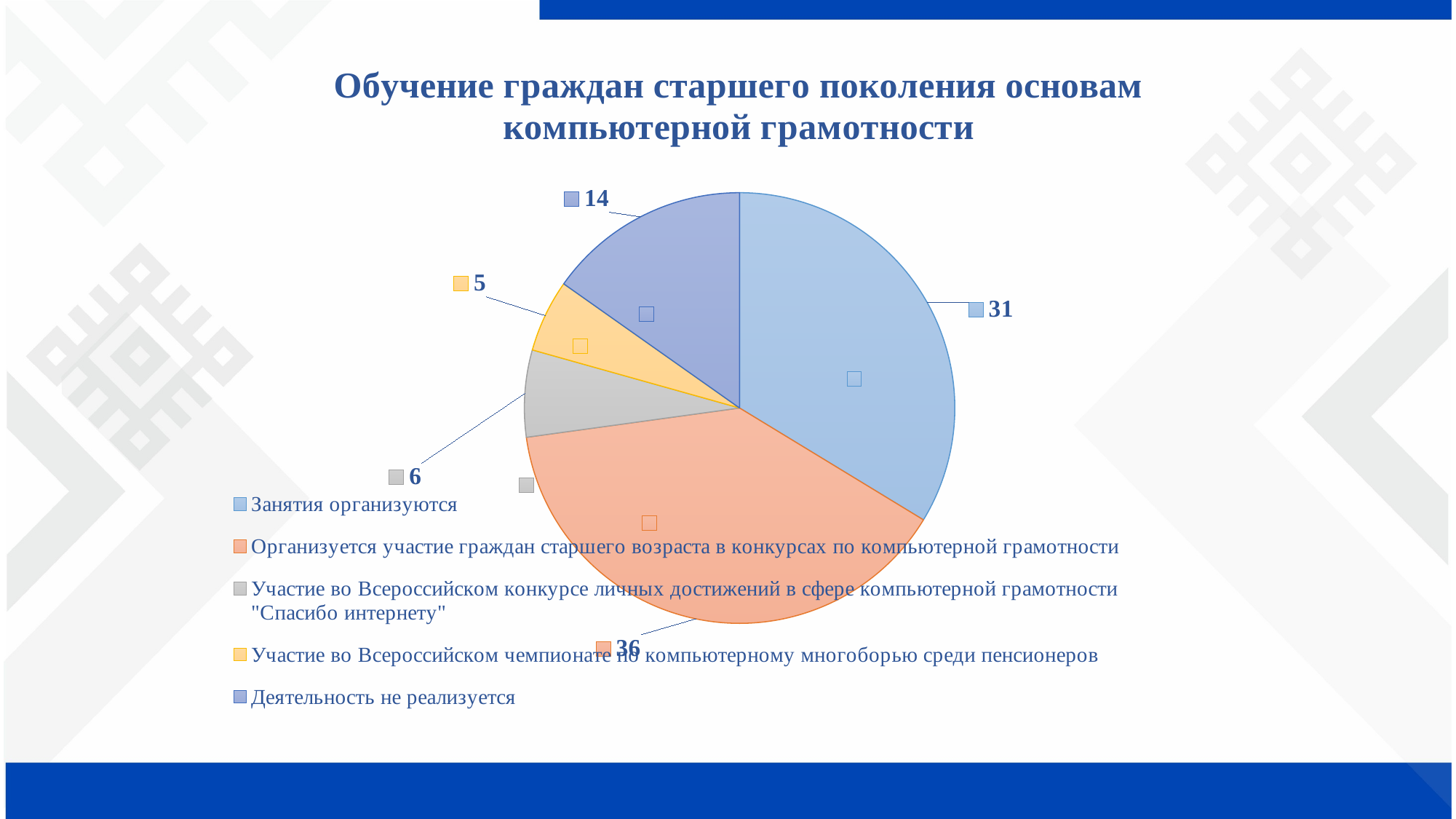
What is the value for "Деятельность не реализуется"? 14 What is the value for "Участие во Всероссийском чемпионате по компьютерному многоборью среди пенсионеров"? 5 Which is larger: the value for "Деятельность не реализуется" or the value for "Занятия организуются"? Занятия организуются How many categories does the pie chart have? 5 What is the value for "Участие во Всероссийском конкурсе личных достижений в сфере компьютерной грамотности "Спасибо интернету""? 6 What is the title of the chart? Обучение граждан старшего поколения основам компьютерной грамотности What type of chart is shown on the slide? pie chart What is the value for "Занятия организуются"? 31 What is the difference between the values for "Организуется участие граждан старшего возраста в конкурсах по компьютерной грамотности" and "Занятия организуются"? 5 Which category has the largest slice of the pie? Организуется участие граждан старшего возраста в конкурсах по компьютерной грамотности What is the value for "Организуется участие граждан старшего возраста в конкурсах по компьютерной грамотности"? 36 Which category has the smallest slice of the pie? Участие во Всероссийском чемпионате по компьютерному многоборью среди пенсионеров